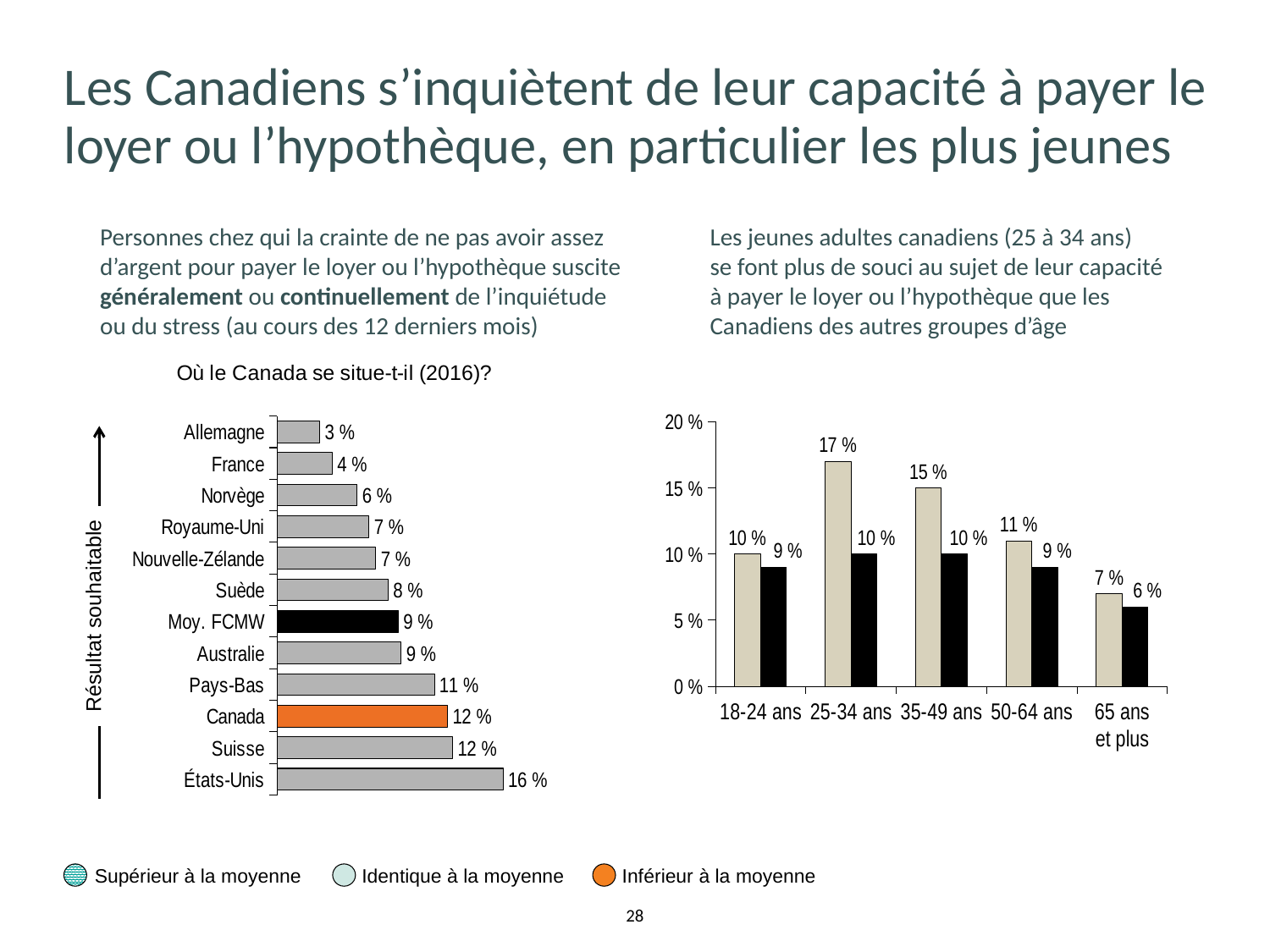
In the left chart 'Où le Canada se situe-t-il (2016)?', what is the value for Allemagne? 3 % In the left chart 'Où le Canada se situe-t-il (2016)?', which country has the lowest value? Allemagne In the left chart 'Où le Canada se situe-t-il (2016)?', which bar is coloured orange? Canada In the right chart by age group, how many age groups are shown? 5 In the left chart 'Où le Canada se situe-t-il (2016)?', which country has the highest value? États-Unis In the left chart 'Où le Canada se situe-t-il (2016)?', what is the value for Canada? 12 % In the right chart by age group, what is the difference between the beige and black bars for 35-49 ans? 5 % In the left chart 'Où le Canada se situe-t-il (2016)?', what is the value for Moy. FCMW? 9 % In the right chart by age group, what is the value of the beige bar for 25-34 ans? 17 % In the right chart by age group, which age group has the highest beige bar? 25-34 ans In the left chart 'Où le Canada se situe-t-il (2016)?', what is the difference between the values for États-Unis and Canada? 4 % In the left chart 'Où le Canada se situe-t-il (2016)?', how many categories are shown? 12